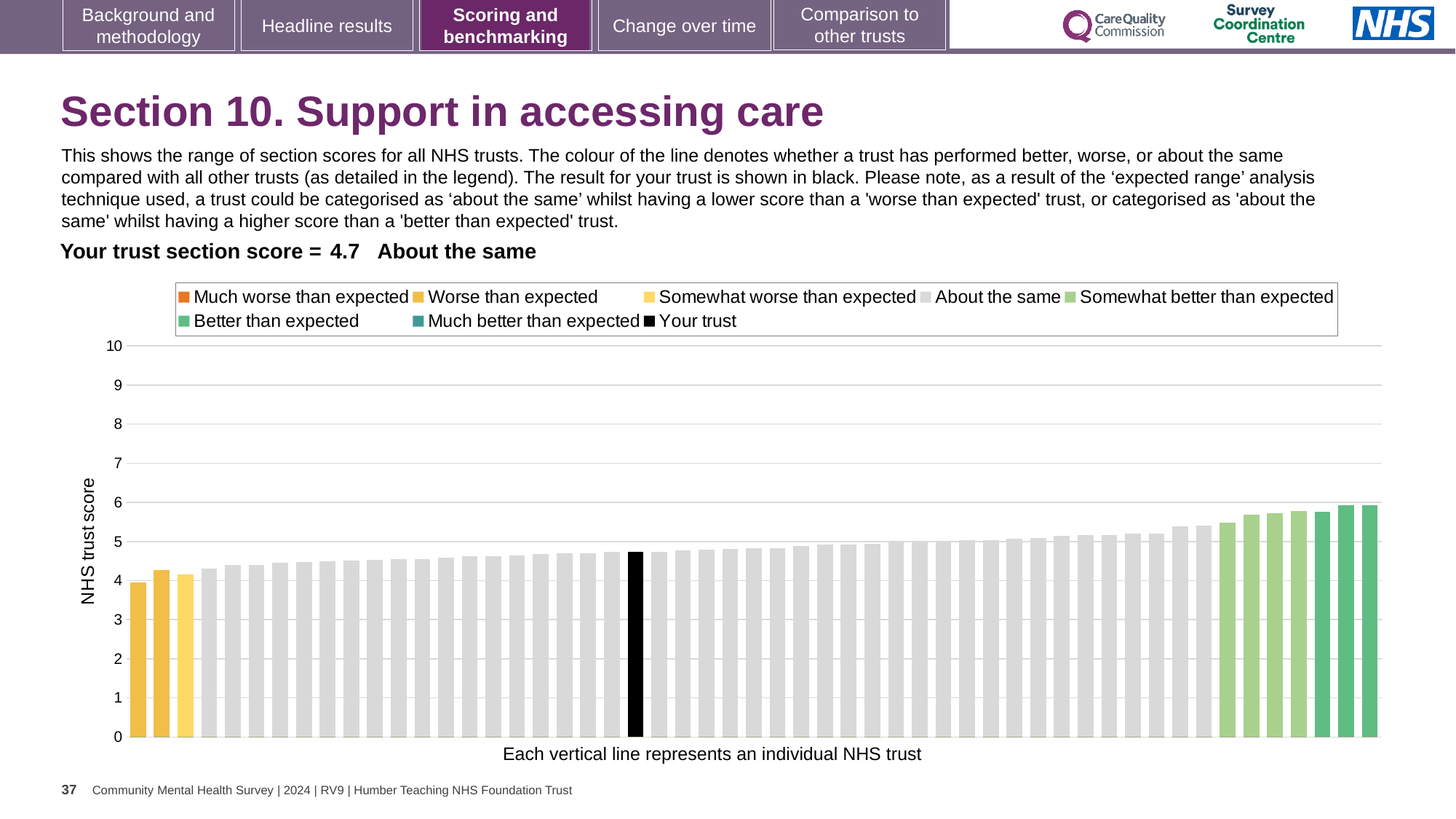
What is the label on the vertical axis? NHS trust score What kind of chart is shown on the slide? bar chart What colour is the bar representing your trust? black How many bars are coloured as 'Worse than expected'? 2 Is the value for your trust greater or less than 4? greater Do the bar values rise or fall from left to right along the x axis? rise Which performance category is your trust placed in for this section? About the same Is the value for your trust greater or less than 5? less What is the section score for your trust? 4.7 Is the value of the lowest bar greater or less than 3? greater How many entries does the chart legend list? 8